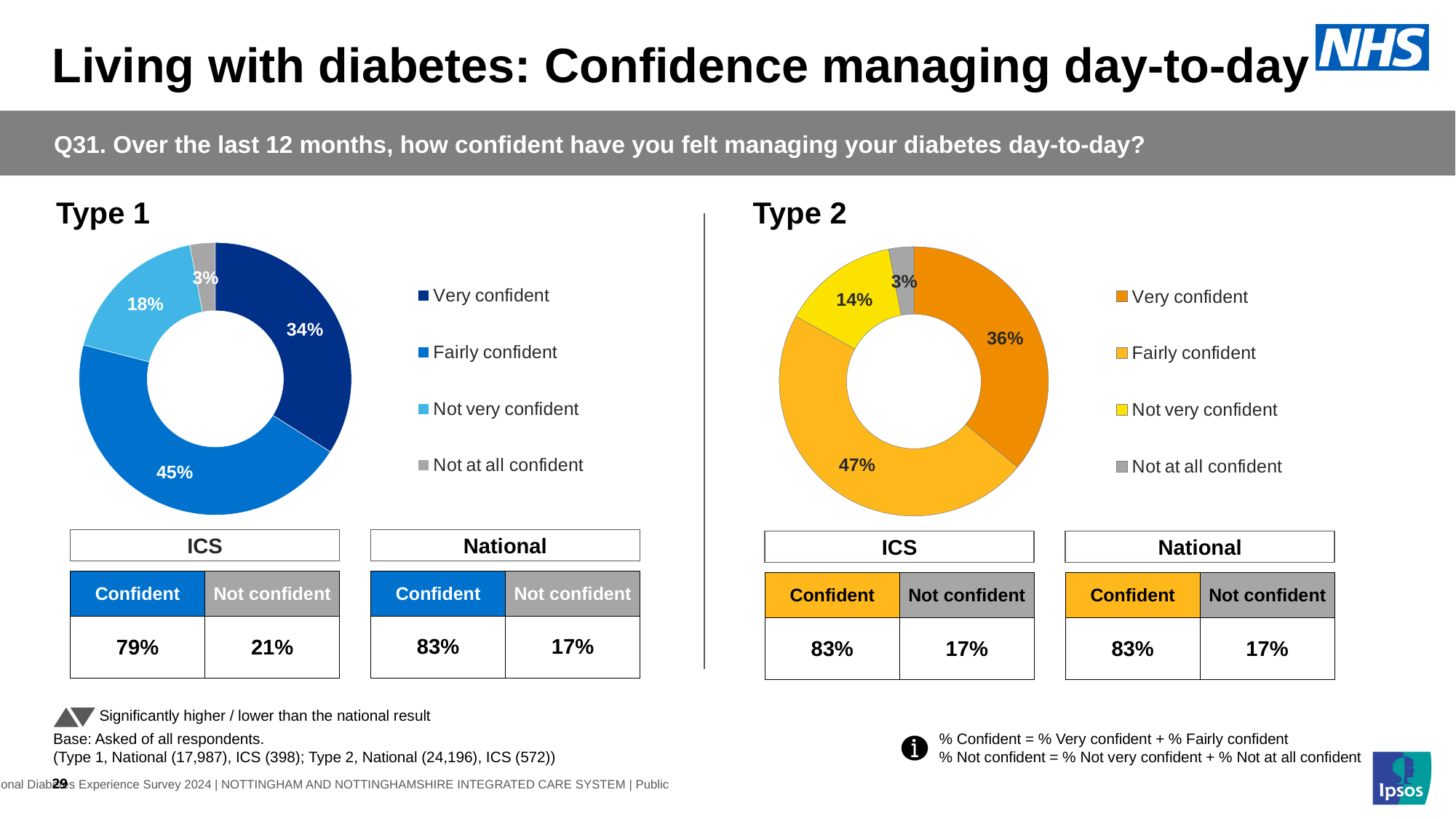
In the Type 2 chart, what percentage of respondents were not very confident? 14% What kind of chart is used for Type 1? Doughnut chart In the Type 1 chart, what is the difference between the fairly confident and very confident shares? 11 percentage points In the Type 1 chart, which category has the largest share? Fairly confident In the Type 1 chart, what percentage of respondents were fairly confident? 45% In the Type 2 chart, what colour represents the fairly confident category? Yellow-orange In the Type 1 chart, what percentage of respondents were very confident? 34% In the Type 2 chart, what percentage of respondents were fairly confident? 47% How many categories does the Type 2 chart show? 4 In the Type 2 chart, which is larger: the very confident share or the not very confident share? Very confident In the Type 1 chart, what is the combined share of not very confident and not at all confident? 21% In the Type 2 chart, which category has the smallest share? Not at all confident